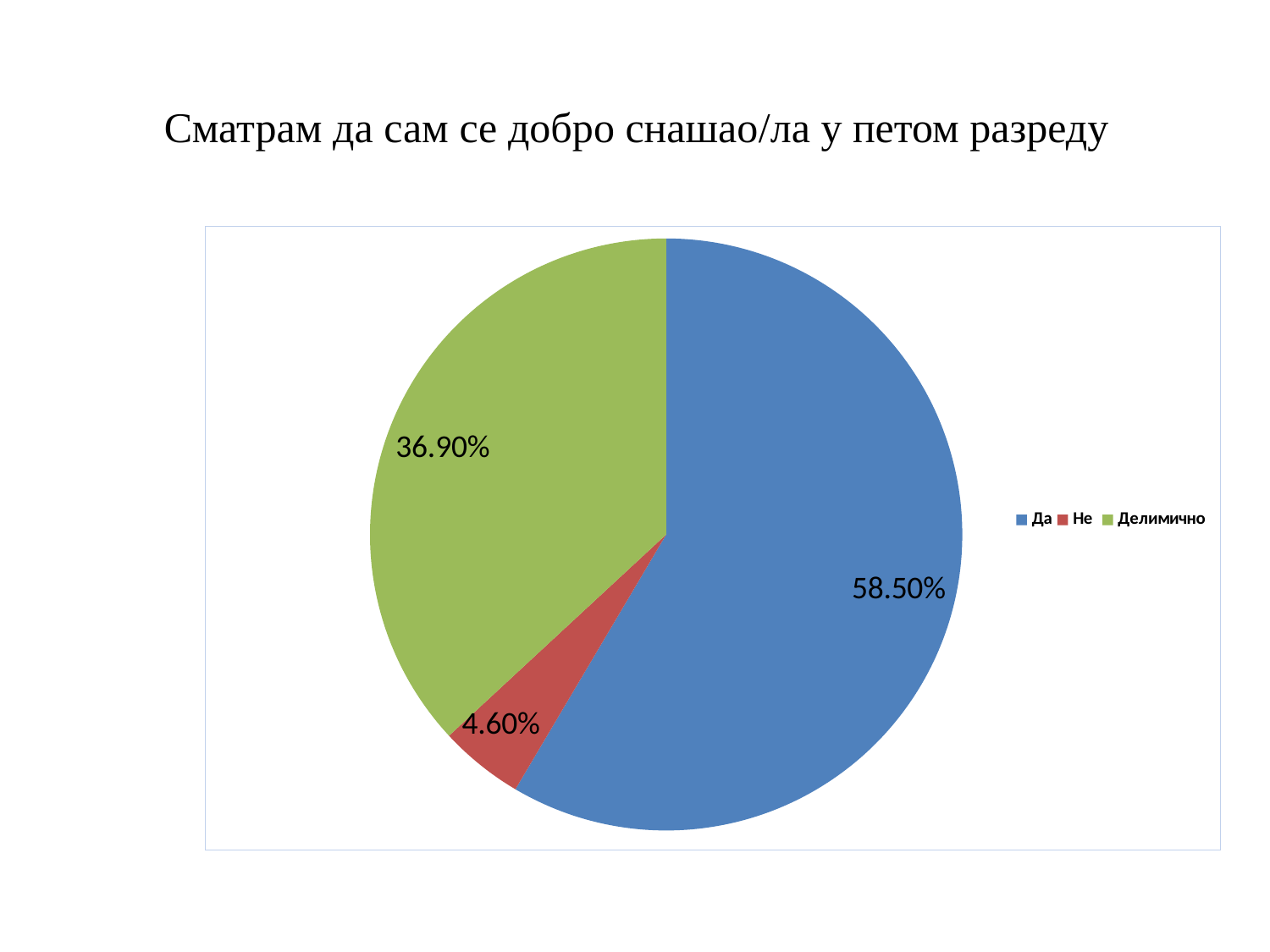
What is the title of the chart on the slide? Сматрам да сам се добро снашао/ла у петом разреду How many slices does the pie chart have? 3 What is the difference in percentage points between the "Да" slice and the "Делимично" slice? 21.60% What percentage of the pie is labelled for the "Не" slice? 4.60% What percentage of the pie is labelled for the "Да" slice? 58.50% Which category has the smallest slice of the pie? Не What colour is the "Не" slice of the pie? red How many entries does the legend list? 3 What percentage of the pie is labelled for the "Делимично" slice? 36.90% What type of chart is shown on the slide? pie chart Which is larger, the "Да" slice or the "Делимично" slice? Да Which category has the largest slice of the pie? Да